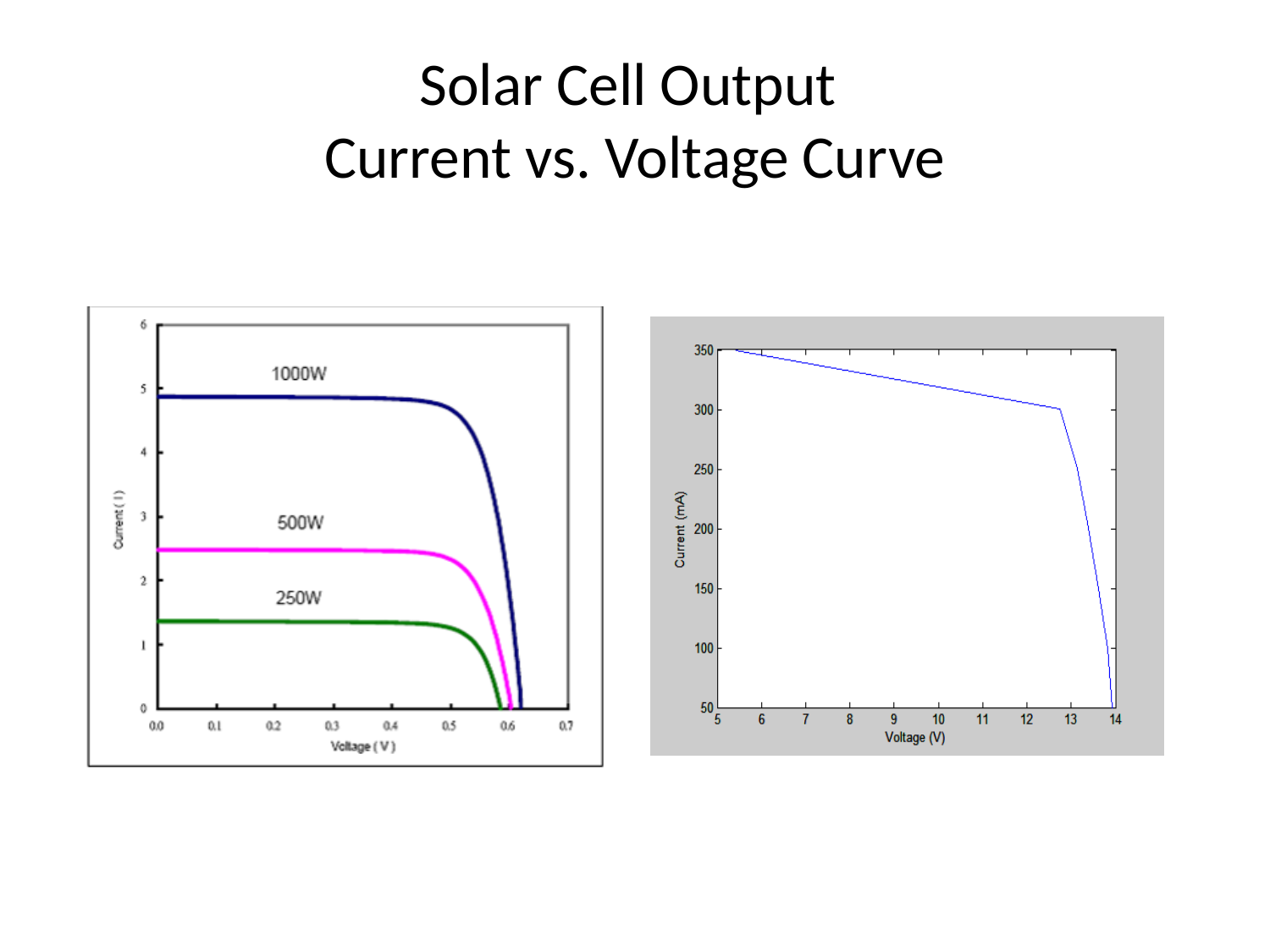
On the left chart, which curve has the lowest current? 250W What kind of chart is the left chart (Current vs. Voltage with 1000W, 500W and 250W curves)? line chart How many curves are plotted on the left chart? 3 On the left chart, is the current of the 500W curve at 0.2 V greater or less than 3? less What kind of chart is the right chart (Current (mA) vs. Voltage (V))? line chart On the left chart, which curve has the highest current? 1000W On the left chart, does the current rise or fall as voltage increases toward 0.6 V? fall On the left chart, at 0.3 V, which curve has the larger current, 500W or 250W? 500W On the right chart, does the current rise or fall as voltage increases from 5 V to 14 V? fall On the right chart, is the current at 9 V greater or less than 300 mA? greater What is the label of the y axis on the right chart? Current (mA) On the left chart, is the current of the 1000W curve at 0.2 V greater or less than 4? greater